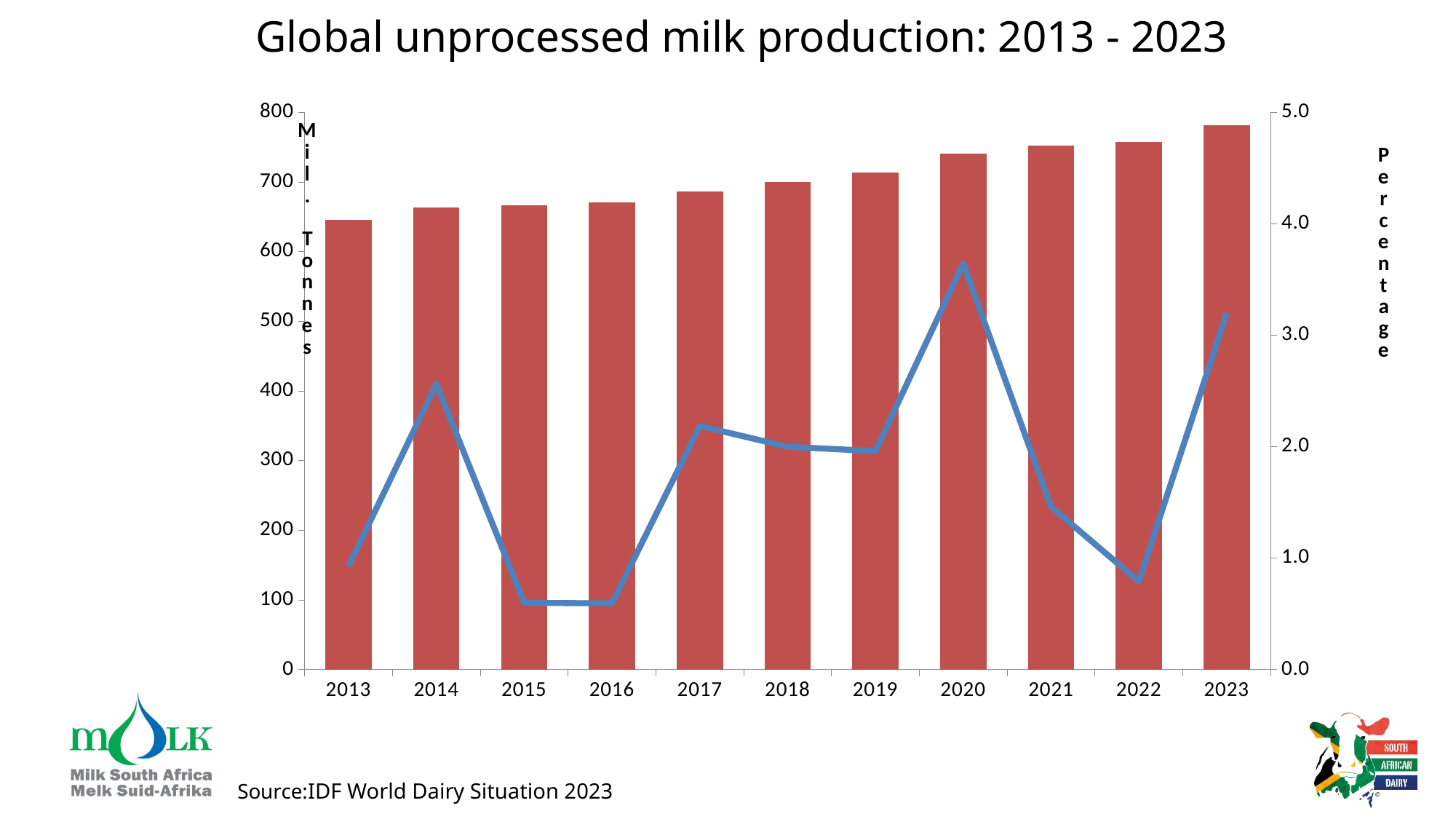
Do the bars for milk production rise or fall from 2013 to 2023? Rise How many years are shown along the x axis? 11 In which year does the percentage line reach its highest point? 2020 Which year has the tallest bar for milk production? 2023 What kind of chart is shown on the slide? A combined bar and line chart Is the bar value for 2013 greater or less than 600 million tonnes? greater What is the title of the chart? Global unprocessed milk production: 2013 - 2023 Which year has the larger percentage value, 2014 or 2021? 2014 Which year has the shortest bar for milk production? 2013 Is the percentage value for 2020 greater or less than 3.0? greater Is the bar value for 2023 greater or less than 700 million tonnes? greater